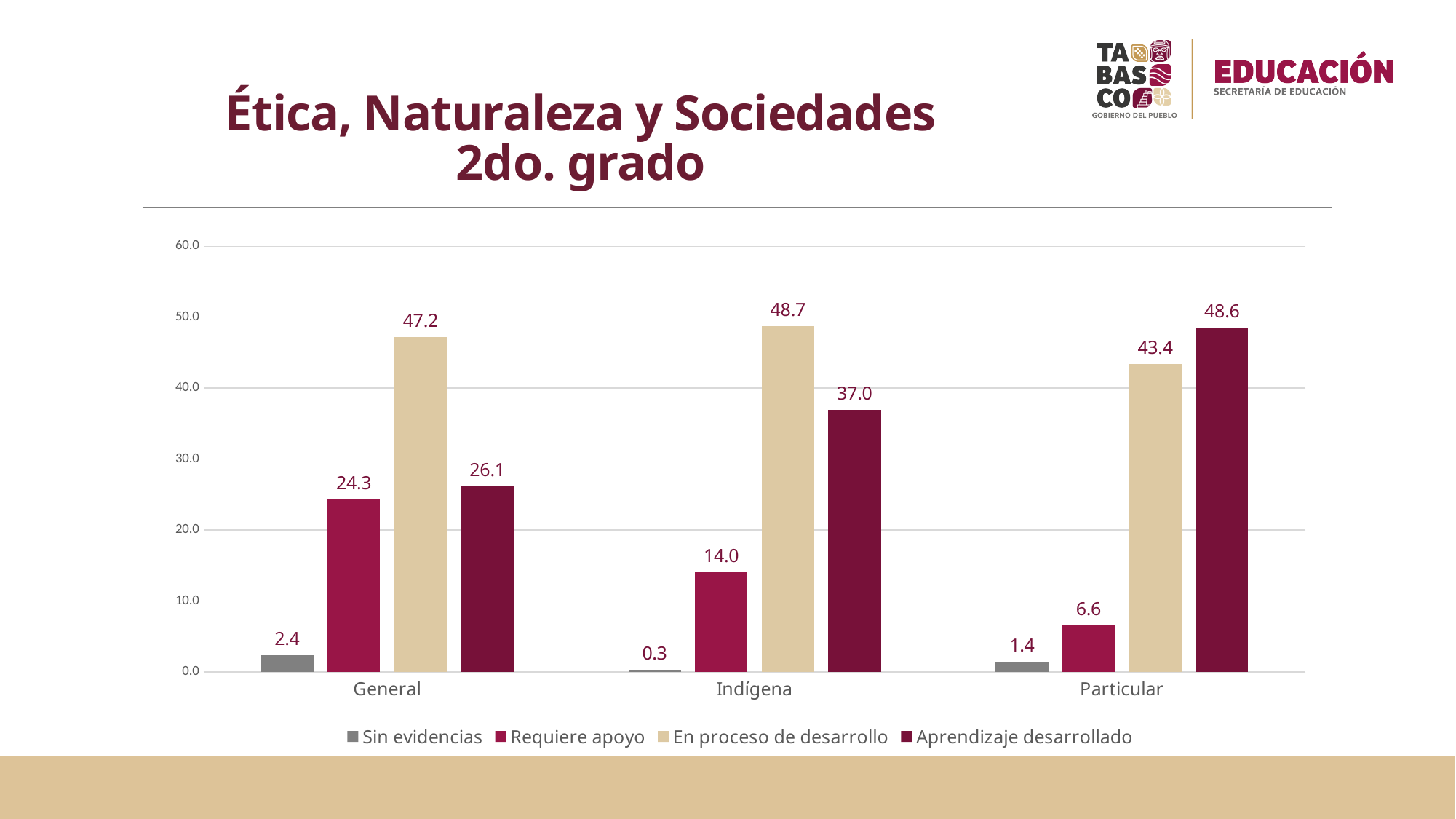
Which category has the highest value for "Aprendizaje desarrollado"? Particular What kind of chart is shown on the slide? Bar chart What is the value for "Aprendizaje desarrollado" in the Indígena category? 37.0 How many series does the legend list? 4 Which is larger in the Particular category: "En proceso de desarrollo" or "Aprendizaje desarrollado"? Aprendizaje desarrollado Which category has the lowest value for "Sin evidencias"? Indígena What is the value for "Sin evidencias" in the Particular category? 1.4 What is the value for "Requiere apoyo" in the Indígena category? 14.0 How many categories are shown on the x axis? 3 What is the value for "En proceso de desarrollo" in the General category? 47.2 What is the title of the slide? Ética, Naturaleza y Sociedades 2do. grado What is the difference between "Requiere apoyo" in General and in Particular? 17.7